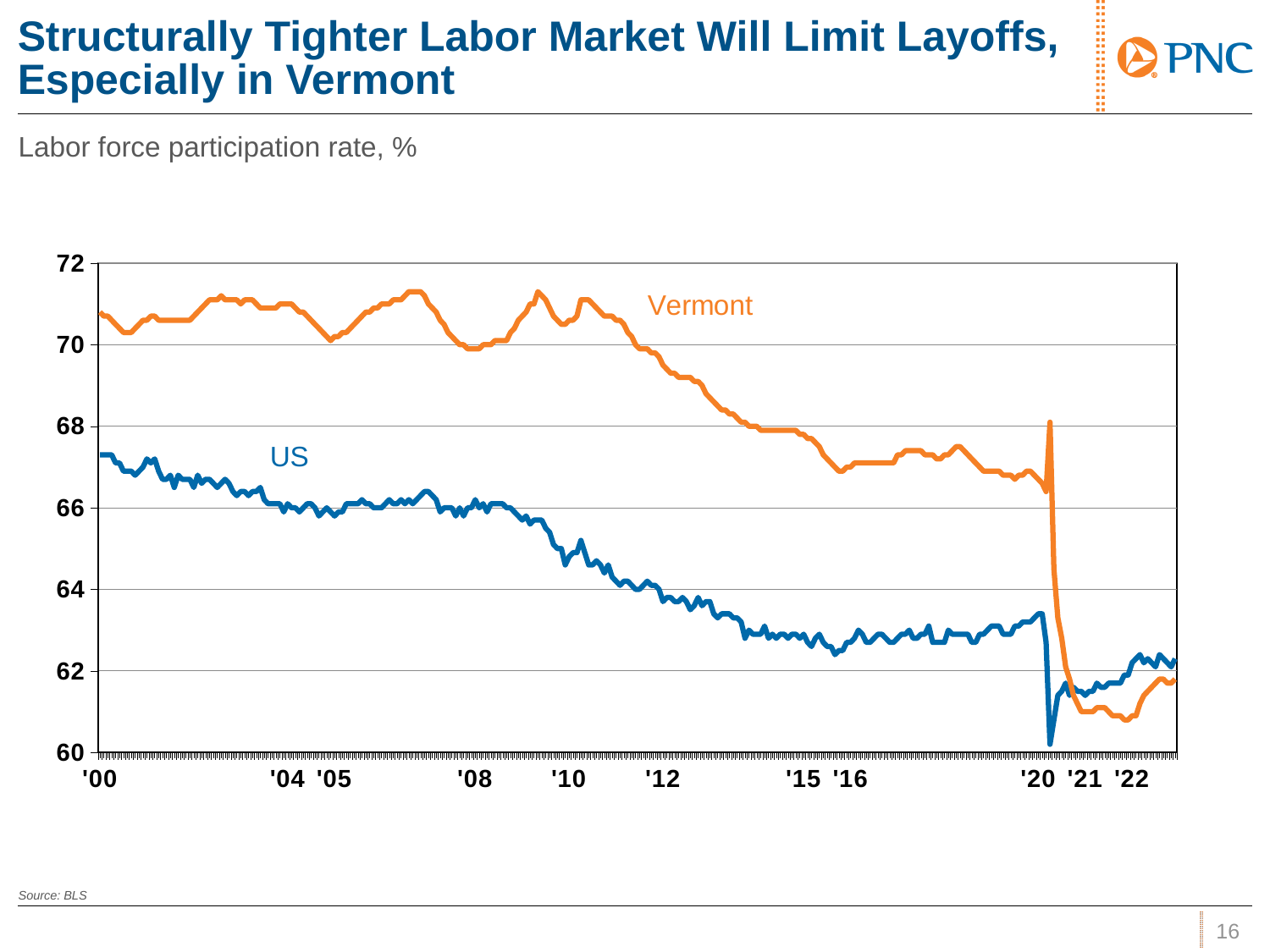
Which two series are labeled on the chart? Vermont and US Does the Vermont labor force participation rate generally rise or fall from '08 to '16? fall Is the Vermont labor force participation rate in '00 greater or less than 70? greater Is the US labor force participation rate in '00 greater or less than 66? greater Is the Vermont labor force participation rate in '16 greater or less than 68? less Which series has the higher labor force participation rate in '10, Vermont or US? Vermont What does the chart measure, according to the subtitle? Labor force participation rate, % What kind of chart is shown on the slide? line chart Does the US labor force participation rate generally rise or fall from '00 to '22? fall How many series are plotted on the chart? 2